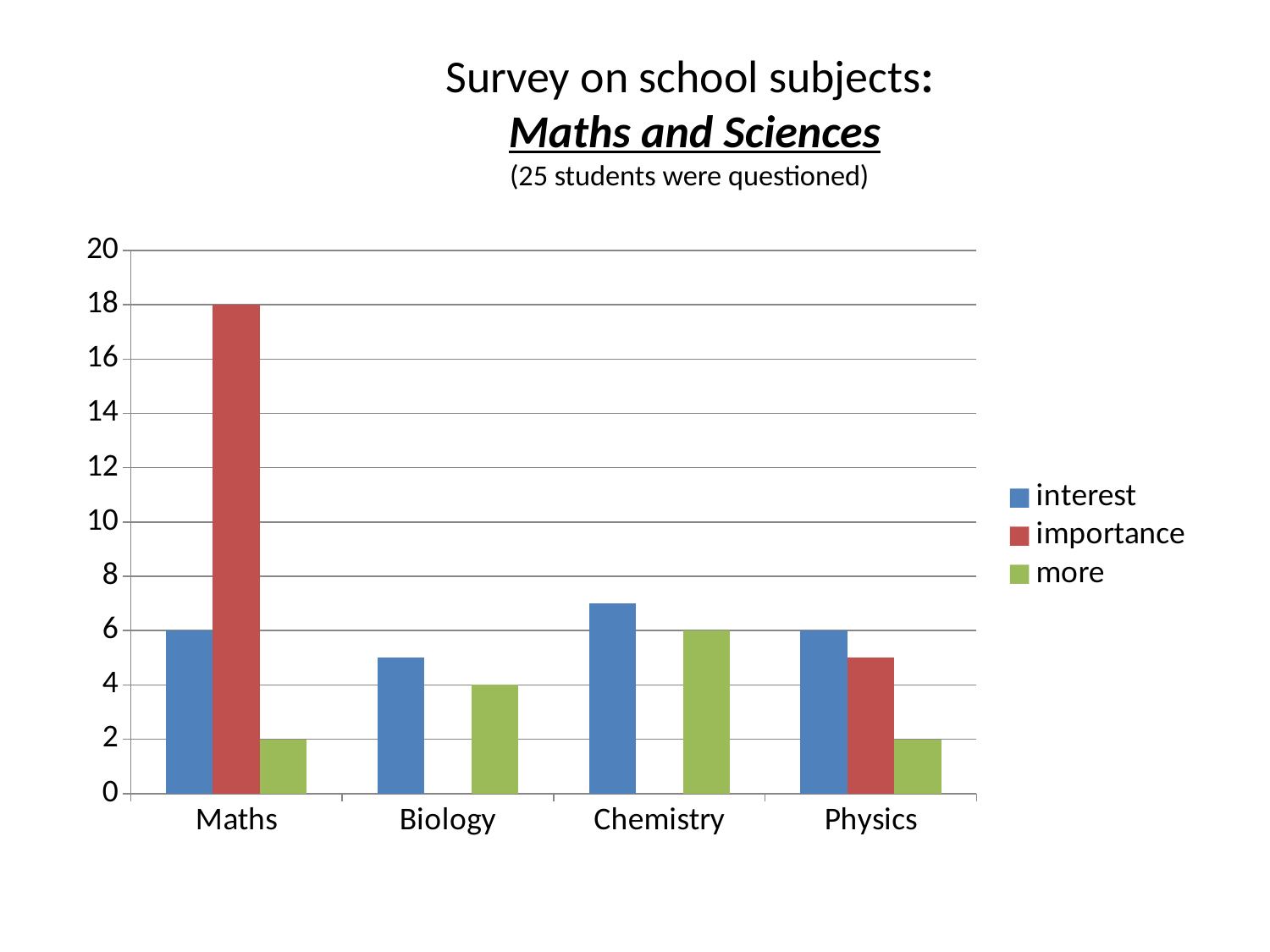
What is the 'more' value for Chemistry? 6 How many series does the legend list? 3 What is the difference between the importance and interest values for Maths? 12 What is the importance value for Maths? 18 What is the interest value for Maths? 6 What is the 'more' value for Biology? 4 Which subject has the highest importance value? Maths Is the interest value for Chemistry greater or less than 6? greater What kind of chart is shown on the slide? Bar chart Is the importance value for Physics greater or less than 6? less How many subjects are shown on the x axis? 4 Which subject has the highest 'more' value? Chemistry